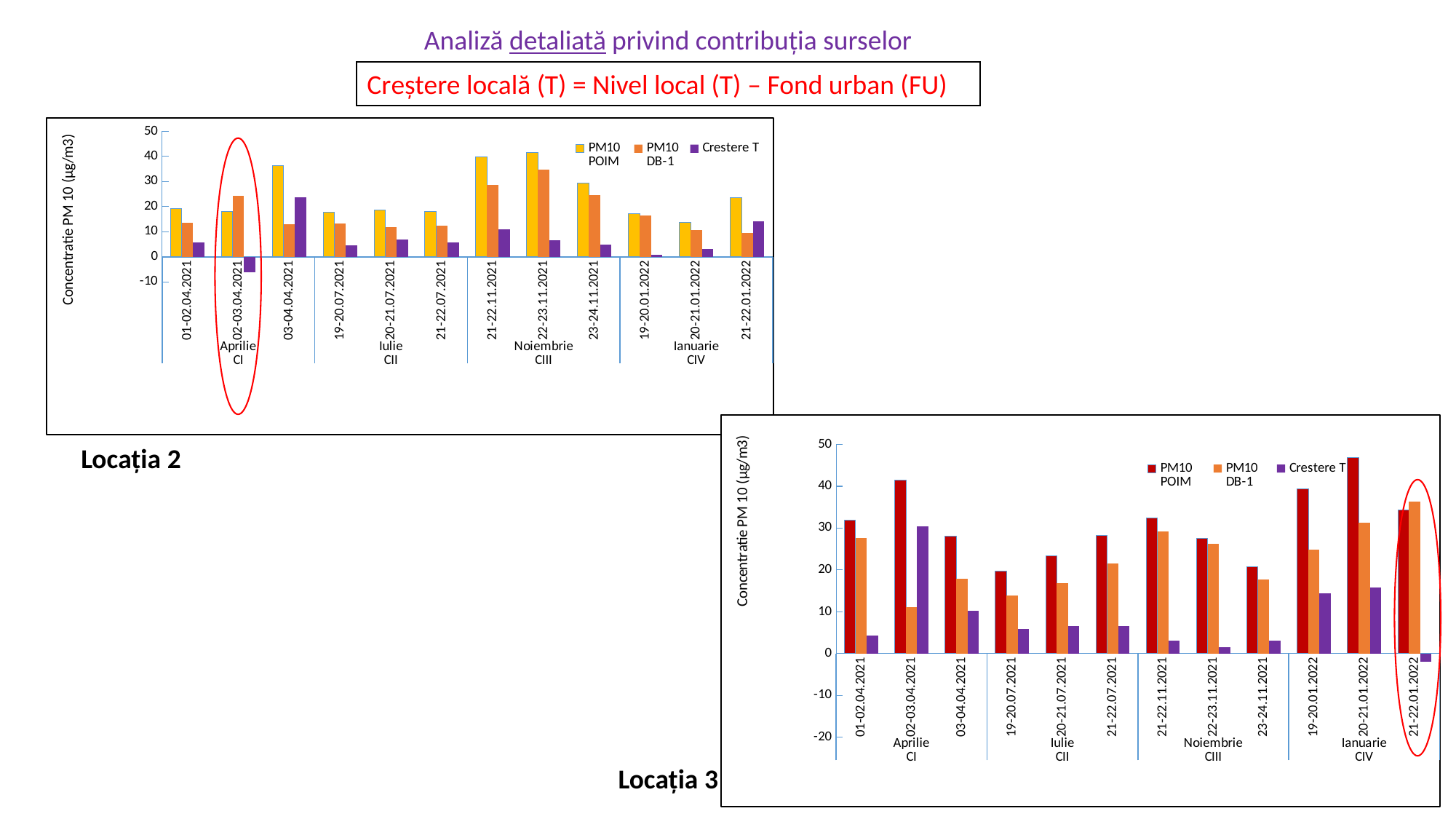
On the Locația 2 chart, for 02-03.04.2021, which is larger: PM10 POIM or PM10 DB-1? PM10 DB-1 On the Locația 3 chart, which date has the highest PM10 POIM value? 20-21.01.2022 On the Locația 3 chart, is the PM10 DB-1 value for 21-22.01.2022 greater or less than 30? greater On the Locația 2 chart, is the PM10 POIM value for 03-04.04.2021 greater or less than 30? greater How many series does the legend of the Locația 3 chart list? 3 On the Locația 2 chart, which date has the lowest Crestere T value? 02-03.04.2021 On the Locația 3 chart, which date has the lowest Crestere T value? 21-22.01.2022 What is the y-axis label of the Locația 3 chart? Concentratie PM 10 (µg/m3) What kind of chart is the Locația 2 chart? bar chart How many date categories are plotted on the Locația 2 chart? 12 On the Locația 3 chart, for 02-03.04.2021, which is larger: PM10 POIM or PM10 DB-1? PM10 POIM On the Locația 2 chart, which date has the highest Crestere T value? 03-04.04.2021